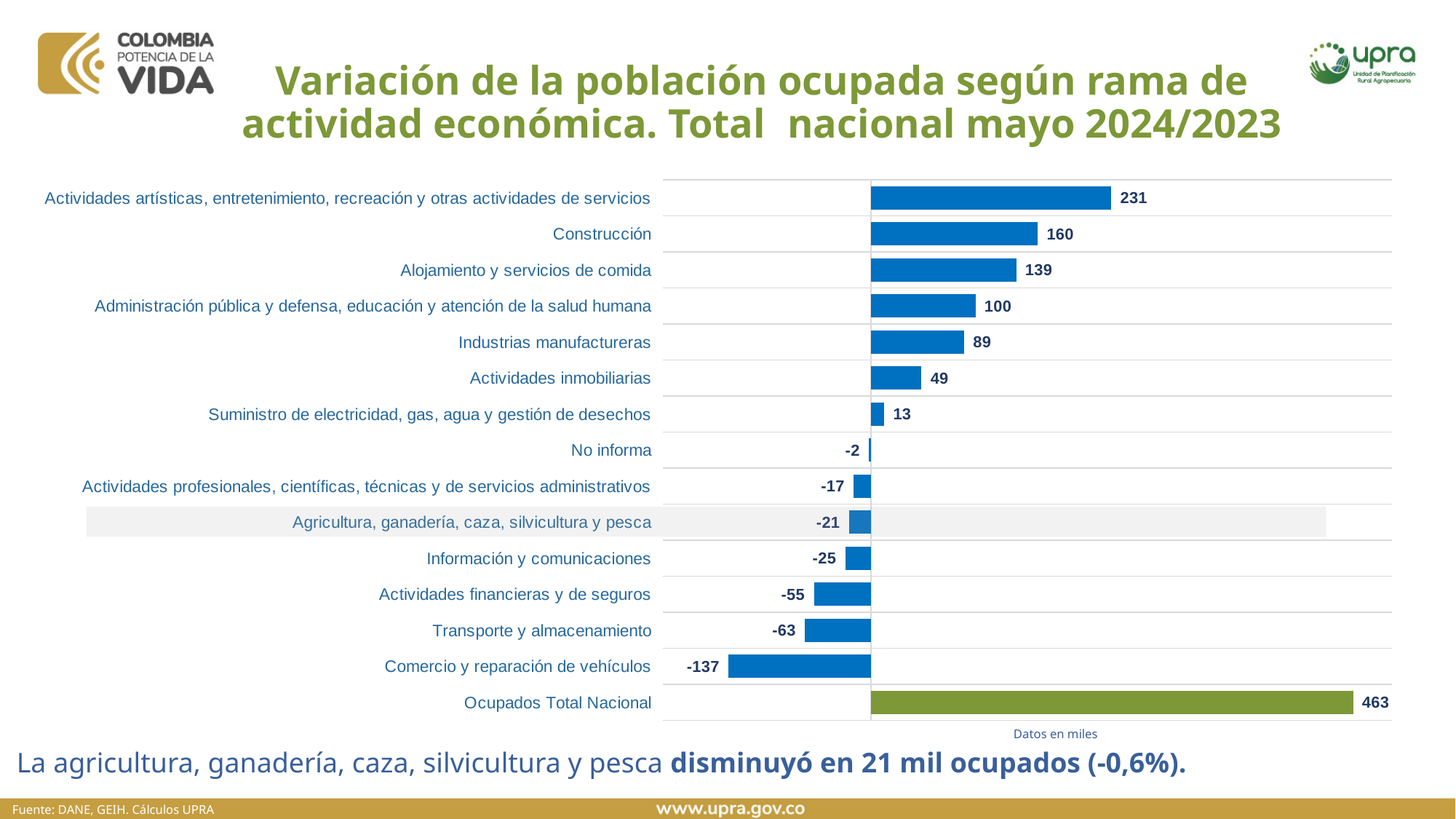
What is the value for Transporte y almacenamiento? -63 What unit note is printed below the chart? Datos en miles What is the value for Comercio y reparación de vehículos? -137 What kind of chart is shown on the slide? Bar chart What is the value for Construcción? 160 Which category has the highest value? Ocupados Total Nacional Which is larger, the value for Alojamiento y servicios de comida or the value for Industrias manufactureras? Alojamiento y servicios de comida What is the value for Ocupados Total Nacional? 463 How many categories are shown in the chart? 15 Which category has the lowest value? Comercio y reparación de vehículos What is the value for Agricultura, ganadería, caza, silvicultura y pesca? -21 What is the difference between the values for Actividades artísticas, entretenimiento, recreación y otras actividades de servicios and Construcción? 71